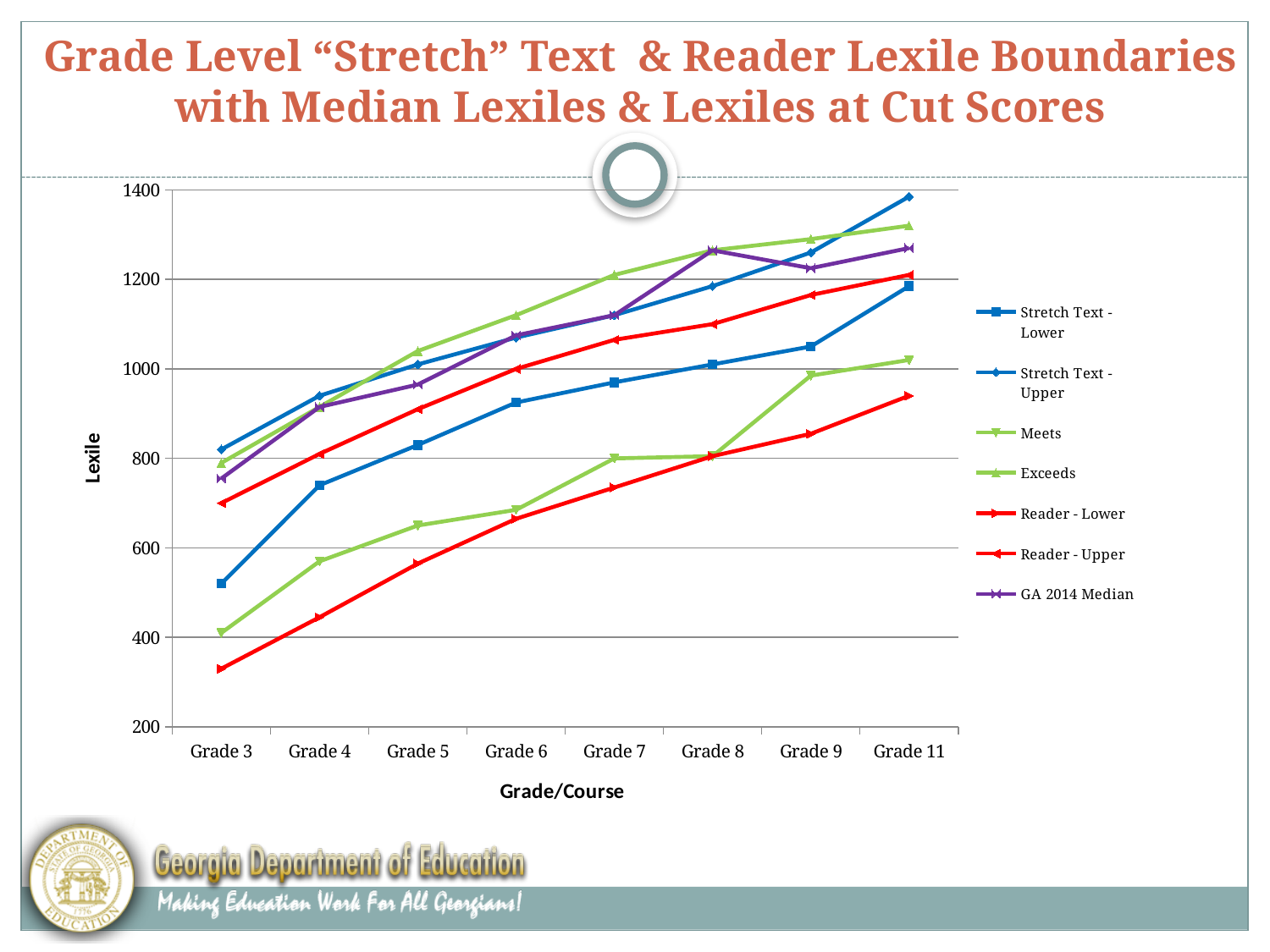
At Grade 3, which is larger: Stretch Text - Upper or Reader - Lower? Stretch Text - Upper What kind of chart is shown on the slide? line chart Which grade has the lowest Reader - Lower value? Grade 3 Is the Exceeds value for Grade 11 greater or less than 1200? greater How many series does the legend list? 7 Is the Meets value for Grade 3 greater or less than 600? less What is the title of the x axis? Grade/Course Which grade has the highest Stretch Text - Upper value? Grade 11 Is the Stretch Text - Upper value for Grade 11 greater or less than 1200? greater Does the Stretch Text - Lower series rise or fall from Grade 3 to Grade 11? rise How many grade/course categories are plotted along the x axis? 8